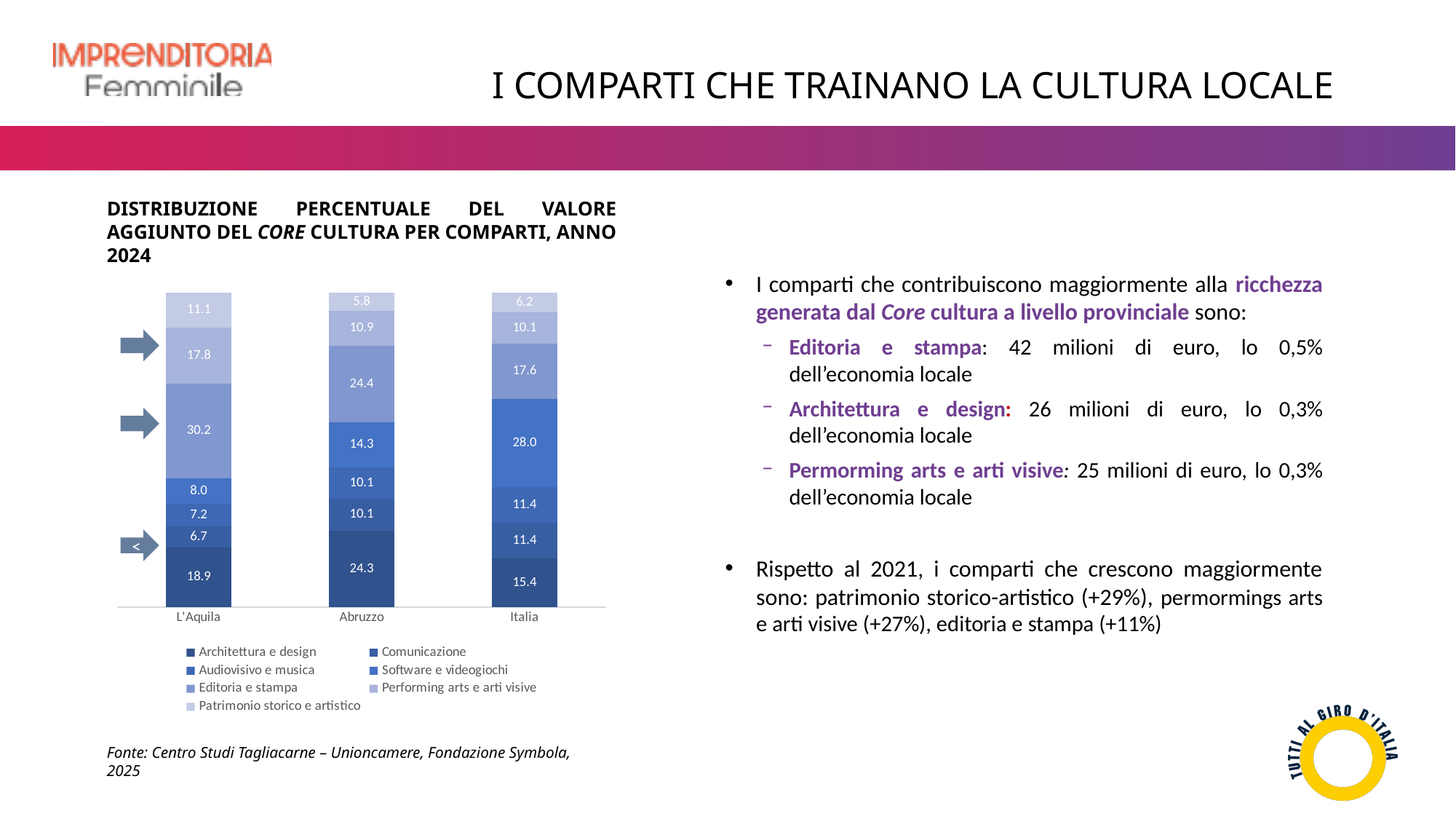
What is the value of the Performing arts e arti visive segment for L'Aquila? 17.8 Is the Software e videogiochi segment larger for Italia (28.0) or for L'Aquila (8.0)? Italia What kind of chart is shown on the slide? Stacked bar chart Which region has the highest value for the bottom segment (Architettura e design)? Abruzzo What is the source cited below the chart? Centro Studi Tagliacarne – Unioncamere, Fondazione Symbola, 2025 What is the value of the bottom segment (Architettura e design) for Abruzzo? 24.3 How many categories (regions) are shown on the x axis of the chart? 3 How many series does the chart legend list? 7 What is the value of the largest segment in the L'Aquila bar? 30.2 Which region has the lowest value for the top segment (Patrimonio storico e artistico)? Abruzzo What is the value of the top segment (Patrimonio storico e artistico) for Italia? 6.2 What is the difference between the Editoria e stampa segment for L'Aquila (30.2) and for Italia (17.6)? 12.6